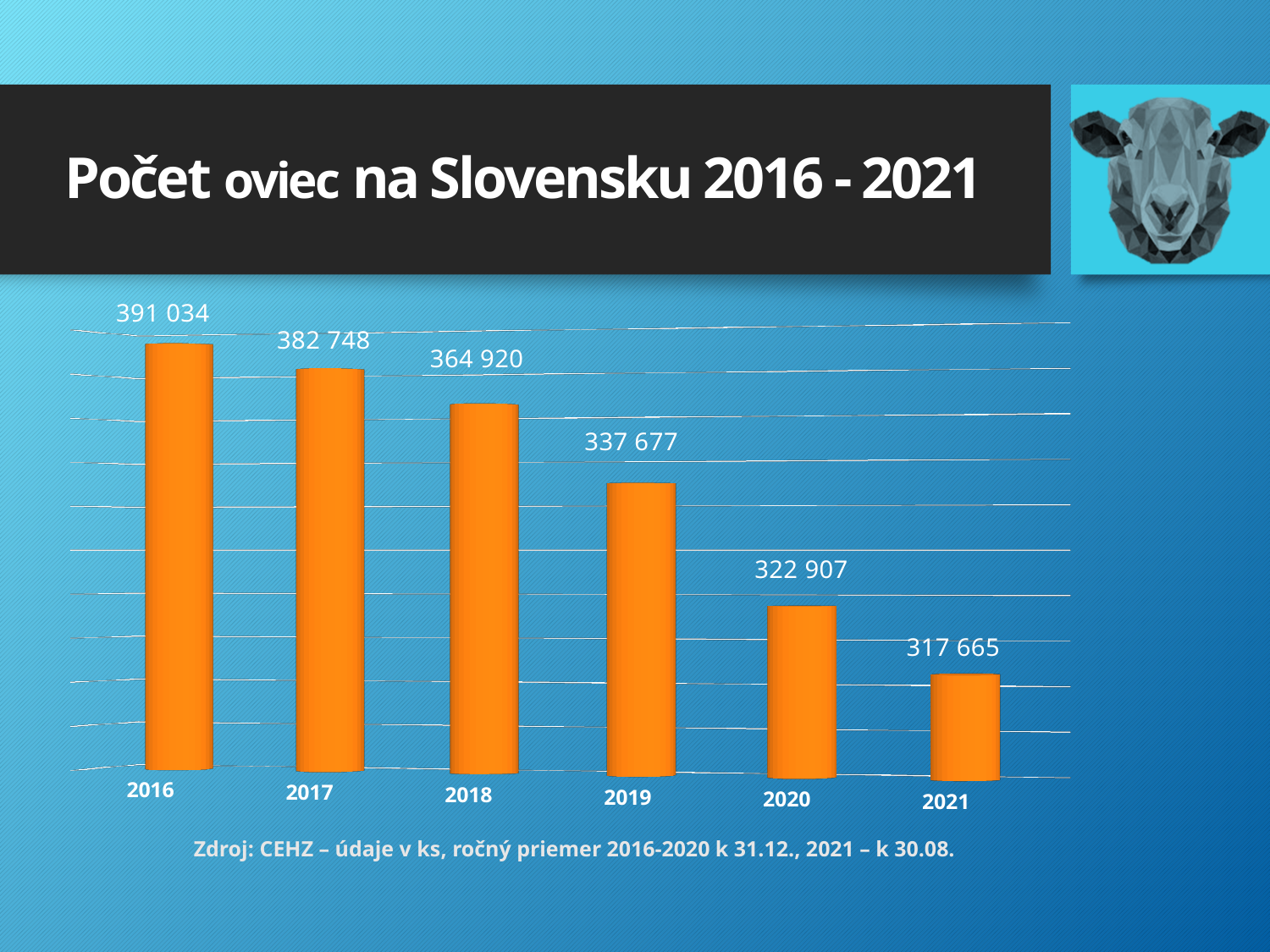
What is the value for 2021? 317 665 What is the difference between the values for 2016 and 2021? 73 369 What is the value for 2019? 337 677 What is the difference between the values for 2018 and 2019? 27 243 Which year has the highest value? 2016 What is the title of the chart? Počet oviec na Slovensku 2016 - 2021 Which is larger, the value for 2017 or the value for 2020? 2017 Do the values rise or fall from 2016 to 2021? fall How many years are shown on the chart? 6 What kind of chart is shown on the slide? bar chart What is the value for 2016? 391 034 Which year has the lowest value? 2021